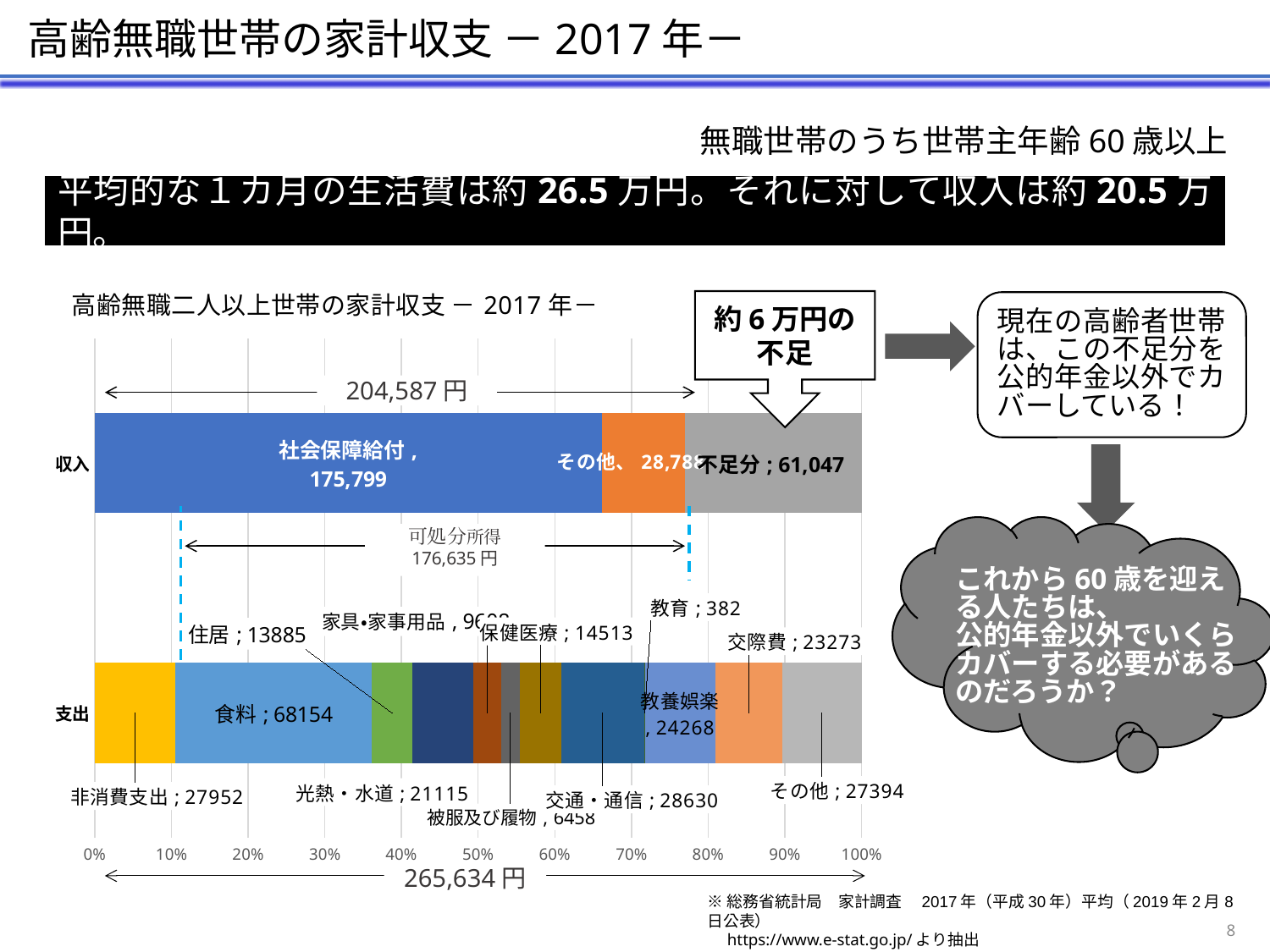
What is the title of the chart? 高齢無職二人以上世帯の家計収支 － 2017 年－ What is the value of 社会保障給付 in the 収入 bar? 175,799 What is the value of 食料 in the 支出 bar? 68154 What is the value of 交際費 in the 支出 bar? 23273 Which is larger in the 支出 bar: 交通・通信 or 非消費支出? 交通・通信 What is the total of the 支出 bar as printed on the slide? 265,634 円 Which category in the 支出 bar has the smallest value? 教育 What is the value of 不足分 in the 収入 bar? 61,047 What is the difference between 社会保障給付 (175,799) and 不足分 (61,047) in the 収入 bar? 114,752 What is the value of 教育 in the 支出 bar? 382 What type of chart is shown on the slide? Stacked bar chart Which category in the 支出 bar has the largest value? 食料